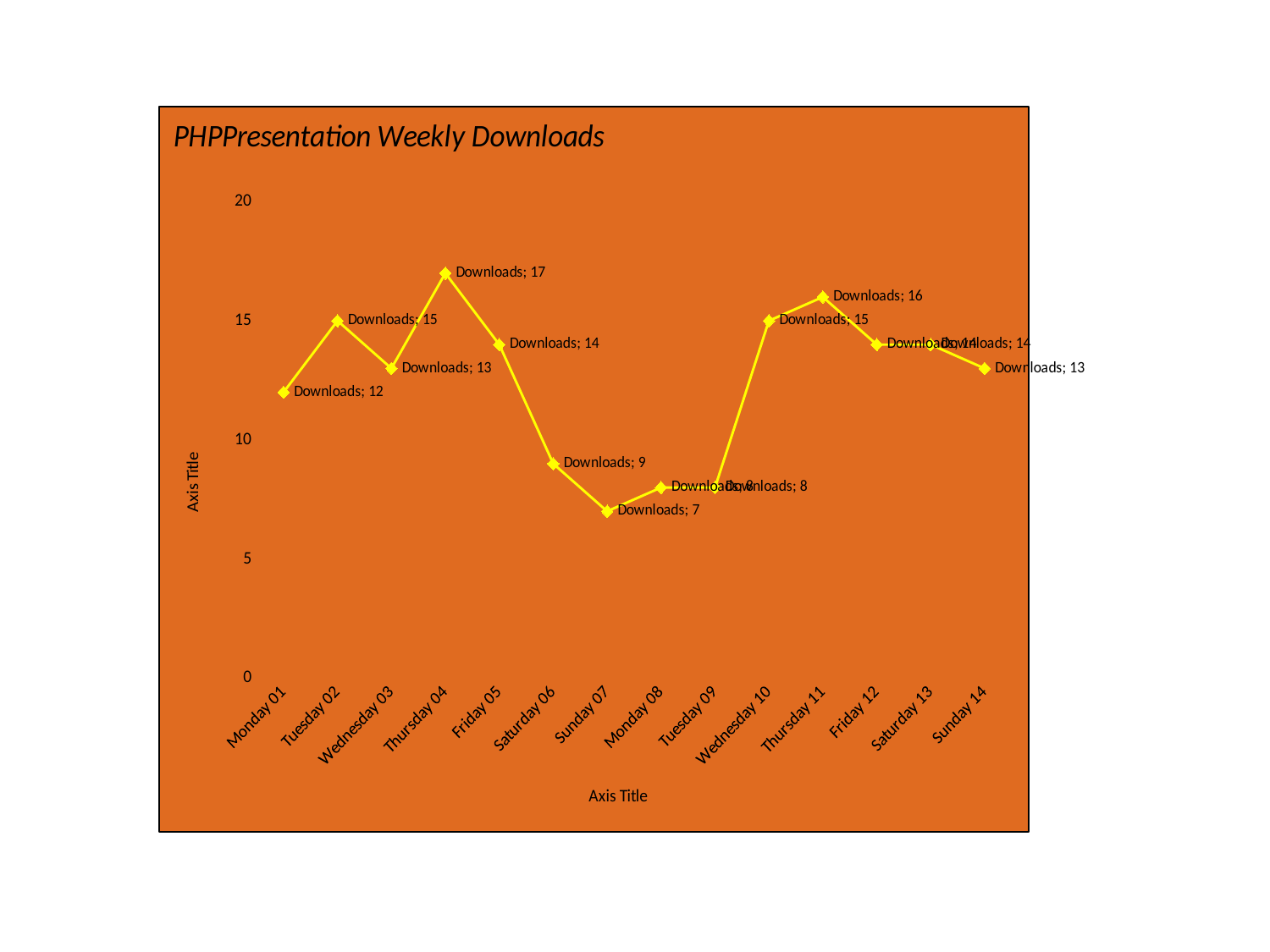
Which day has the highest number of downloads? Thursday 04 What is the difference between the values for Thursday 04 and Sunday 07? 10 What type of chart is shown on the slide? line chart What is the value for Thursday 04? 17 Which is larger, the value for Tuesday 02 or the value for Wednesday 03? Tuesday 02 What is the title of the chart? PHPPresentation Weekly Downloads Which day has the lowest number of downloads? Sunday 07 What is the value for Monday 01? 12 Do the values rise or fall from Thursday 04 to Sunday 07? fall How many data points are plotted on the chart? 14 What is the value for Sunday 07? 7 What is the value for Thursday 11? 16